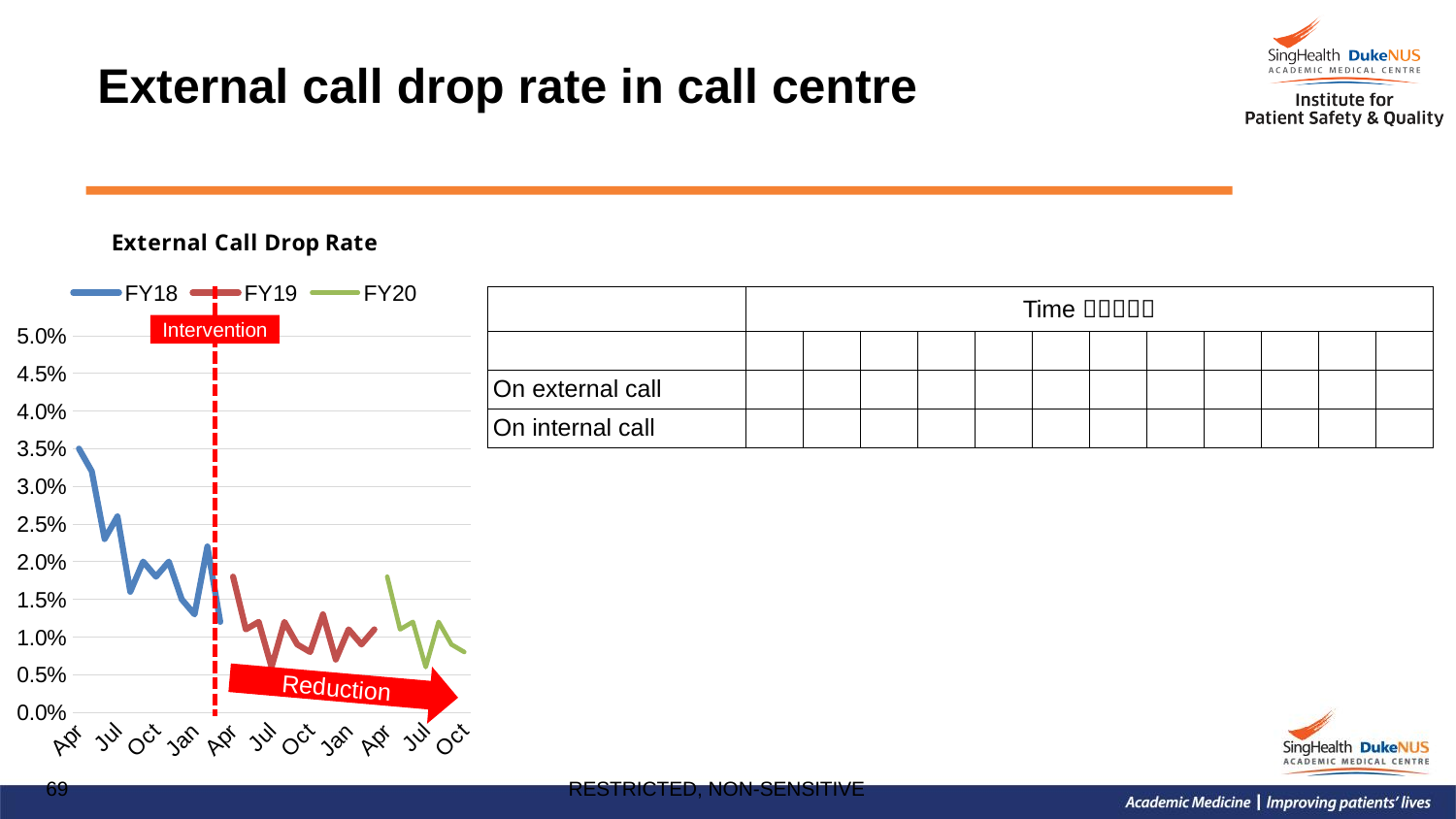
Is the FY18 value at the first Apr larger than any FY20 value? yes Which series has the highest values on the External Call Drop Rate chart? FY18 How many series does the legend of the External Call Drop Rate chart list? 3 Is the highest FY20 value greater or less than 2.5%? less What is the title of the chart on the slide? External Call Drop Rate How many month labels are shown along the x axis of the External Call Drop Rate chart? 11 What kind of chart is shown on the slide? line chart Is the FY18 value at the first Apr greater or less than 3.0%? greater What is the highest value shown on the y axis of the External Call Drop Rate chart? 5.0% Is the highest FY19 value greater or less than 2.5%? less Which series are listed in the legend of the External Call Drop Rate chart? FY18, FY19, FY20 Does the FY18 line generally rise or fall from Apr to the following Apr? fall